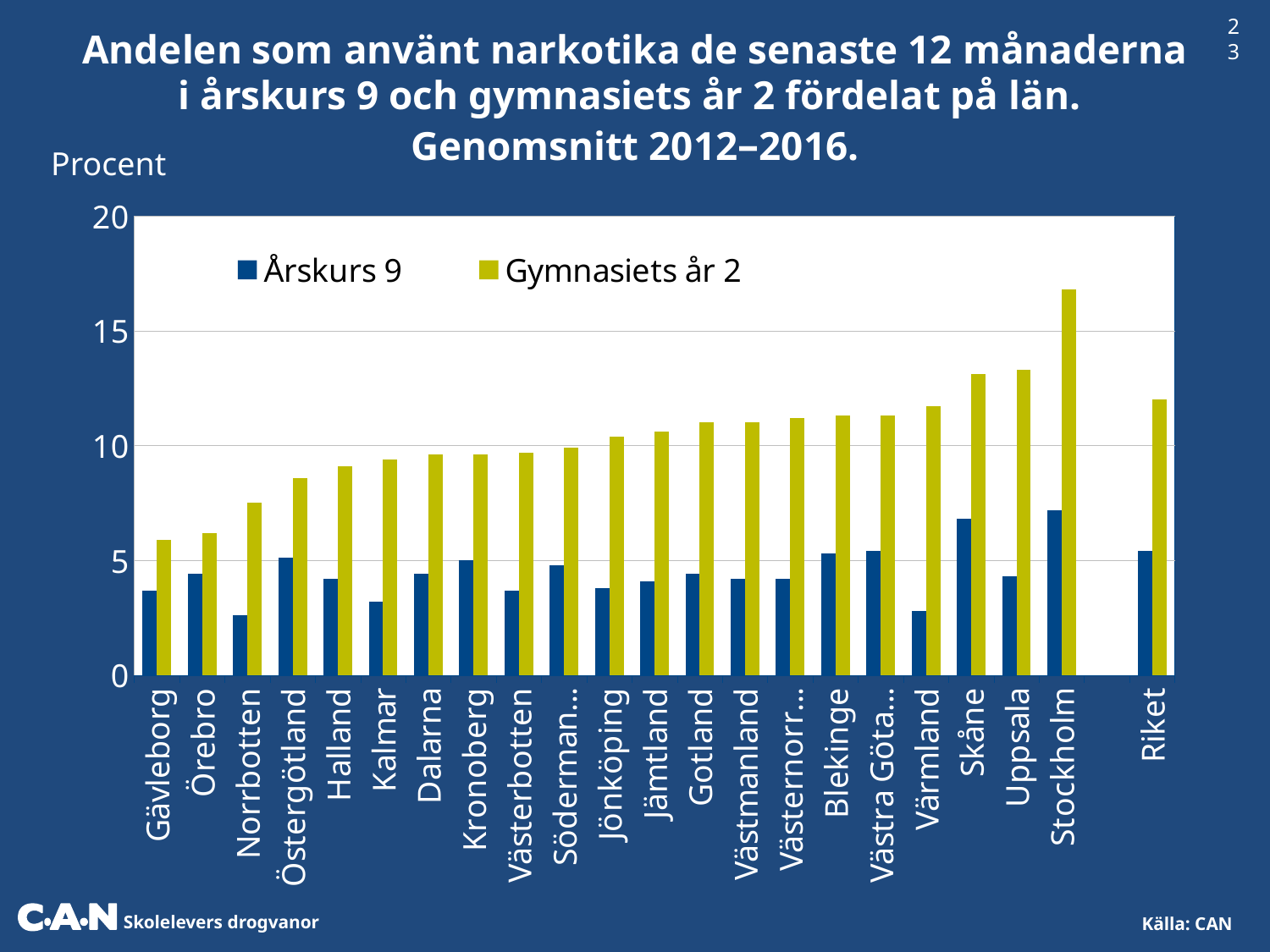
Is the value for Stockholm in the Gymnasiets år 2 series greater or less than 15? greater Is the value for Norrbotten in the Årskurs 9 series greater or less than 5? less Is the value for Riket in the Gymnasiets år 2 series greater or less than 10? greater Which is larger for Årskurs 9: Skåne or Uppsala? Skåne Which category has the highest value for Årskurs 9? Stockholm What kind of chart is shown on the slide? bar chart How many series does the legend list? 2 Do the Gymnasiets år 2 values generally rise or fall from Gävleborg to Stockholm along the x axis? rise Which category has the lowest value for Gymnasiets år 2? Gävleborg Which category has the highest value for Gymnasiets år 2? Stockholm How many categories are shown on the x axis? 22 What are the two series named in the legend? Årskurs 9 and Gymnasiets år 2